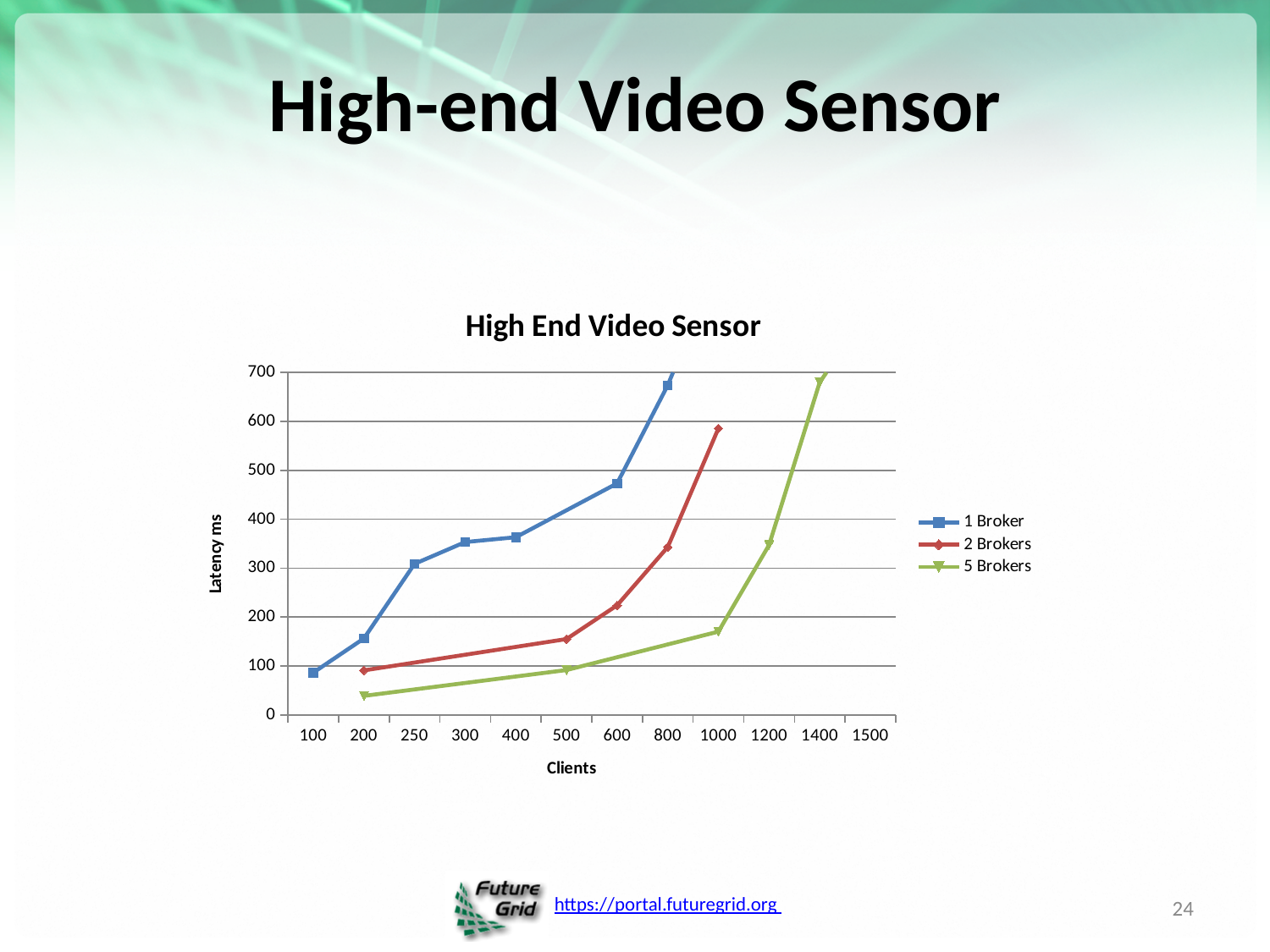
Is the latency for 5 Brokers at 200 clients greater or less than 100? less Is the latency for 1 Broker at 800 clients greater or less than 600? greater Is the latency for 5 Brokers at 1000 clients greater or less than 200? less How many client values are shown along the x axis? 12 How many series does the legend list? 3 What kind of chart is shown on the slide? line chart What is the title of the chart? High End Video Sensor Does the latency for 1 Broker rise or fall as the number of clients increases? rise What is the label of the y axis? Latency ms At 800 clients, which series has the higher latency, 1 Broker or 2 Brokers? 1 Broker